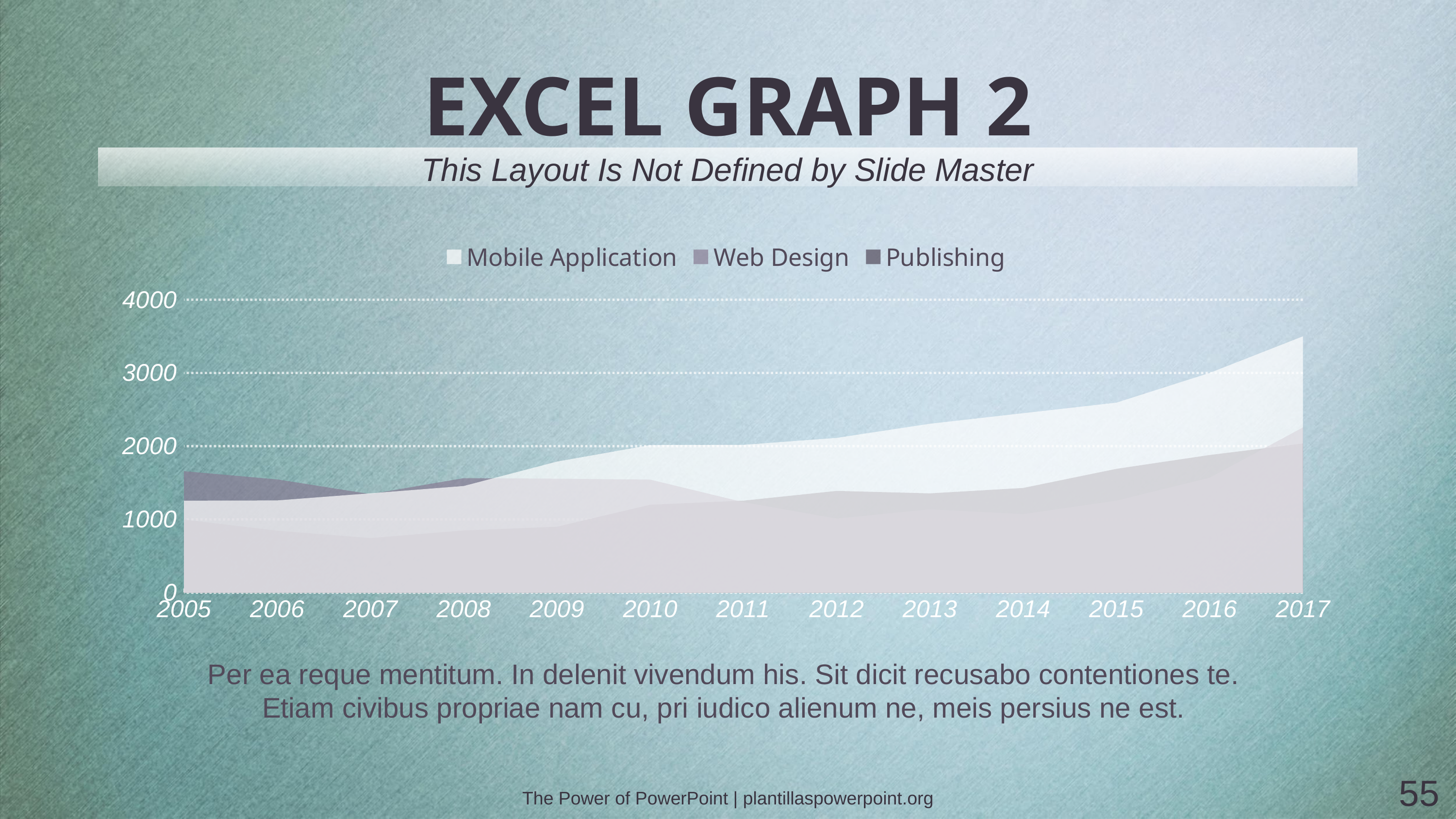
Which series are listed in the chart legend? Mobile Application, Web Design, Publishing How many years are shown on the x axis? 13 What is the title of the slide containing the chart? EXCEL GRAPH 2 In which year does Mobile Application reach its highest value? 2017 Is the value for Publishing in 2005 greater or less than 2000? less Does the Mobile Application series rise or fall from 2005 to 2017? Rise What kind of chart is shown on the slide? Area chart How many series does the legend list? 3 Is the value for Mobile Application in 2017 greater or less than 4000? less Is the value for Mobile Application in 2017 greater or less than 3000? greater In 2017, which is larger: Mobile Application or Web Design? Mobile Application